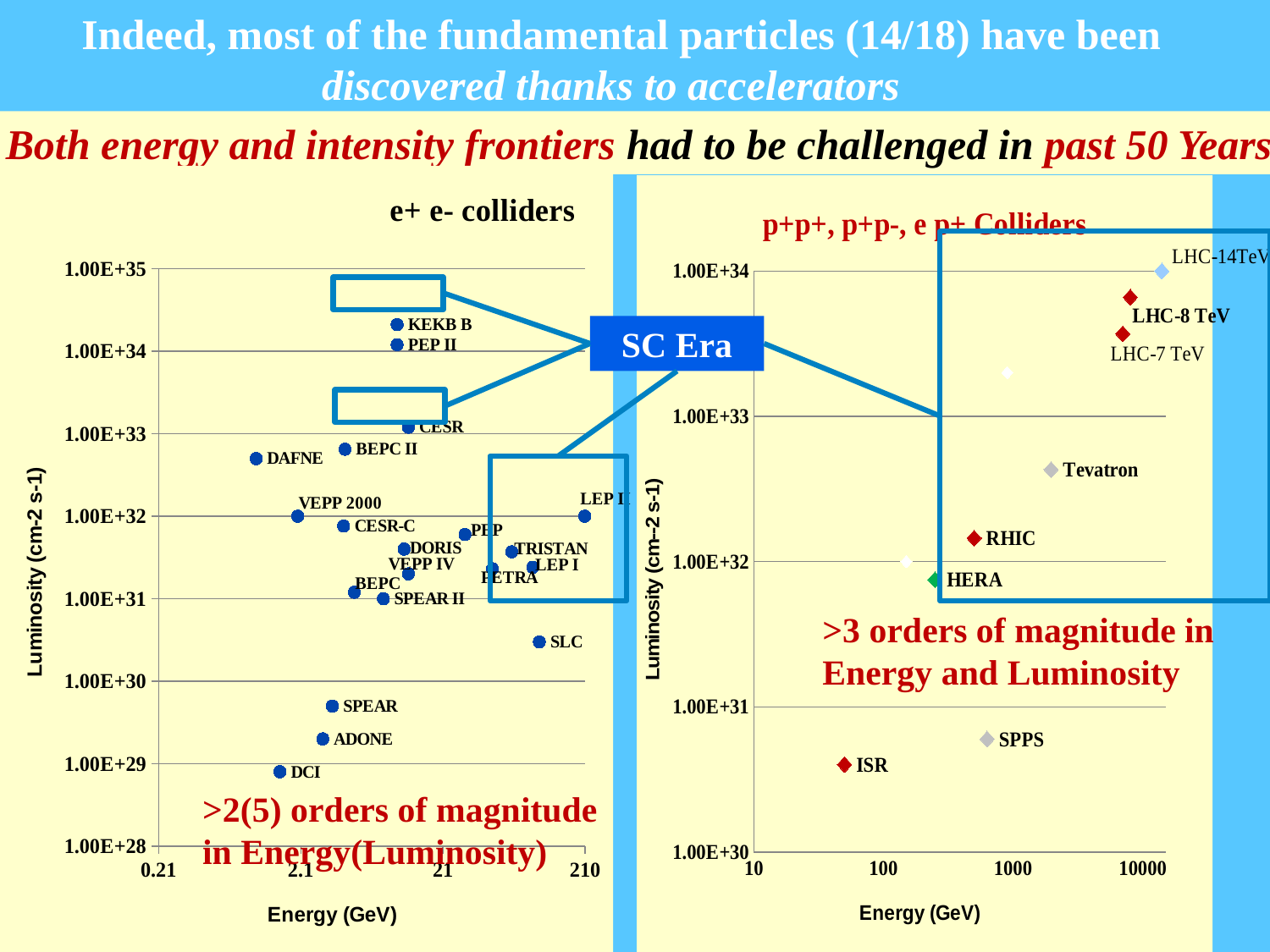
In the 'e+ e- colliders' chart, which has the higher luminosity, KEKB B or PEP II? KEKB B In the 'p+p+, p+p-, e p+ Colliders' chart, which collider has the highest luminosity? LHC-14TeV In the 'e+ e- colliders' chart, is the luminosity of KEKB B greater or less than 1.00E+34? greater What kind of chart is the 'e+ e- colliders' chart? scatter chart In the 'p+p+, p+p-, e p+ Colliders' chart, is the energy of ISR greater or less than 100 GeV? less In the 'p+p+, p+p-, e p+ Colliders' chart, is the luminosity of Tevatron greater or less than 1.00E+32? greater In the 'e+ e- colliders' chart, which collider has the lowest luminosity? DCI In the 'p+p+, p+p-, e p+ Colliders' chart, which has the higher luminosity, Tevatron or RHIC? Tevatron In the 'p+p+, p+p-, e p+ Colliders' chart, which collider has the lowest luminosity? ISR What is the x-axis title of the 'p+p+, p+p-, e p+ Colliders' chart? Energy (GeV) In the 'e+ e- colliders' chart, which collider has the highest luminosity? KEKB B